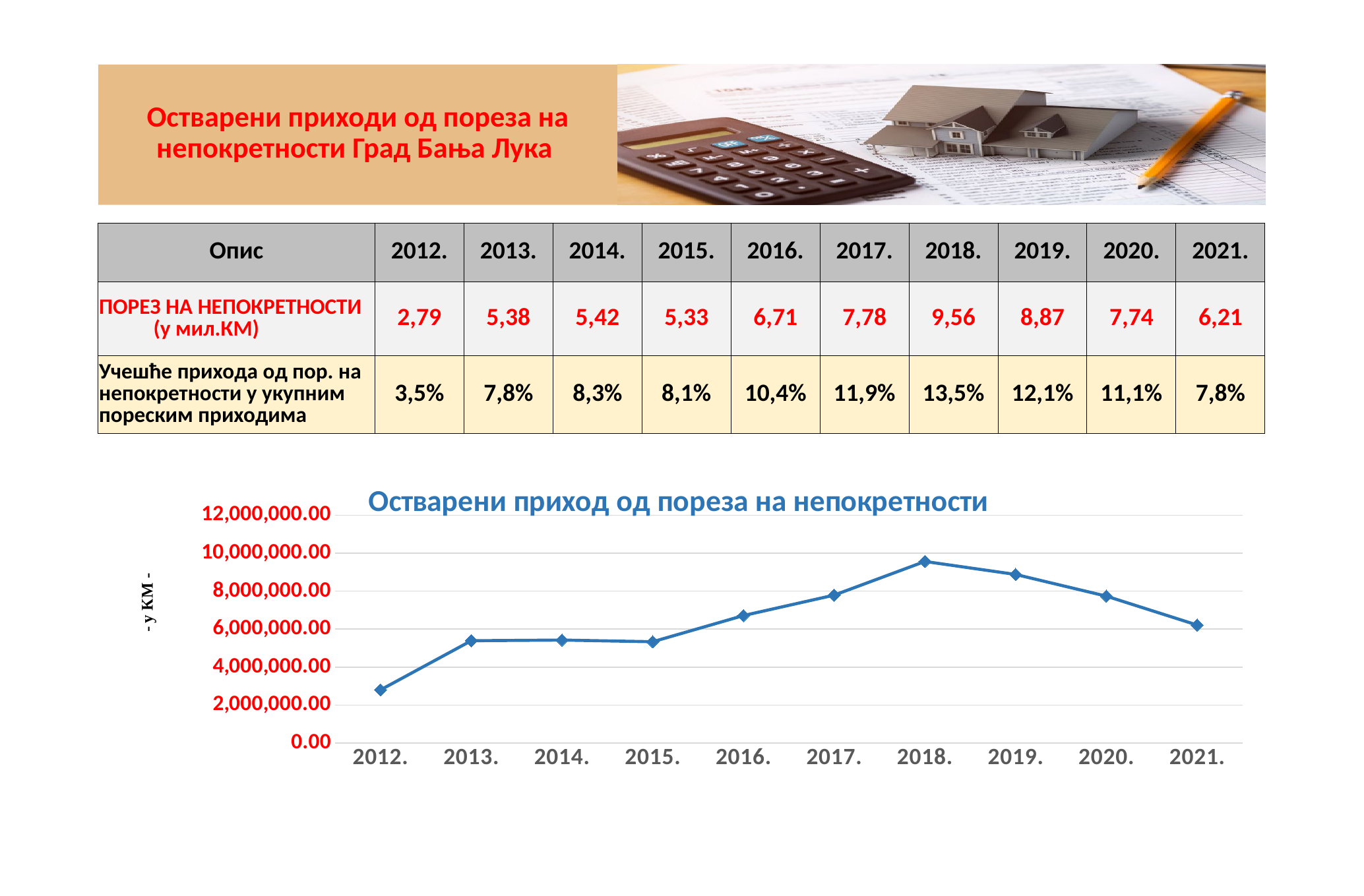
Is the value for 2018. greater or less than 10,000,000.00? less Is the value for 2012. greater or less than 4,000,000.00? less Is the value for 2016. greater or less than 6,000,000.00? greater Which is larger in the chart, the value for 2016. or the value for 2019.? 2019. What is the label on the vertical axis of the chart? - у КМ - What kind of chart is shown on the slide? line chart What is the title of the chart? Остварени приход од пореза на непокретности Which year has the lowest value in the chart? 2012. How many years are plotted on the x axis of the chart? 10 Do the values in the chart rise or fall from 2018. to 2021.? fall Which year has the highest value in the chart? 2018.